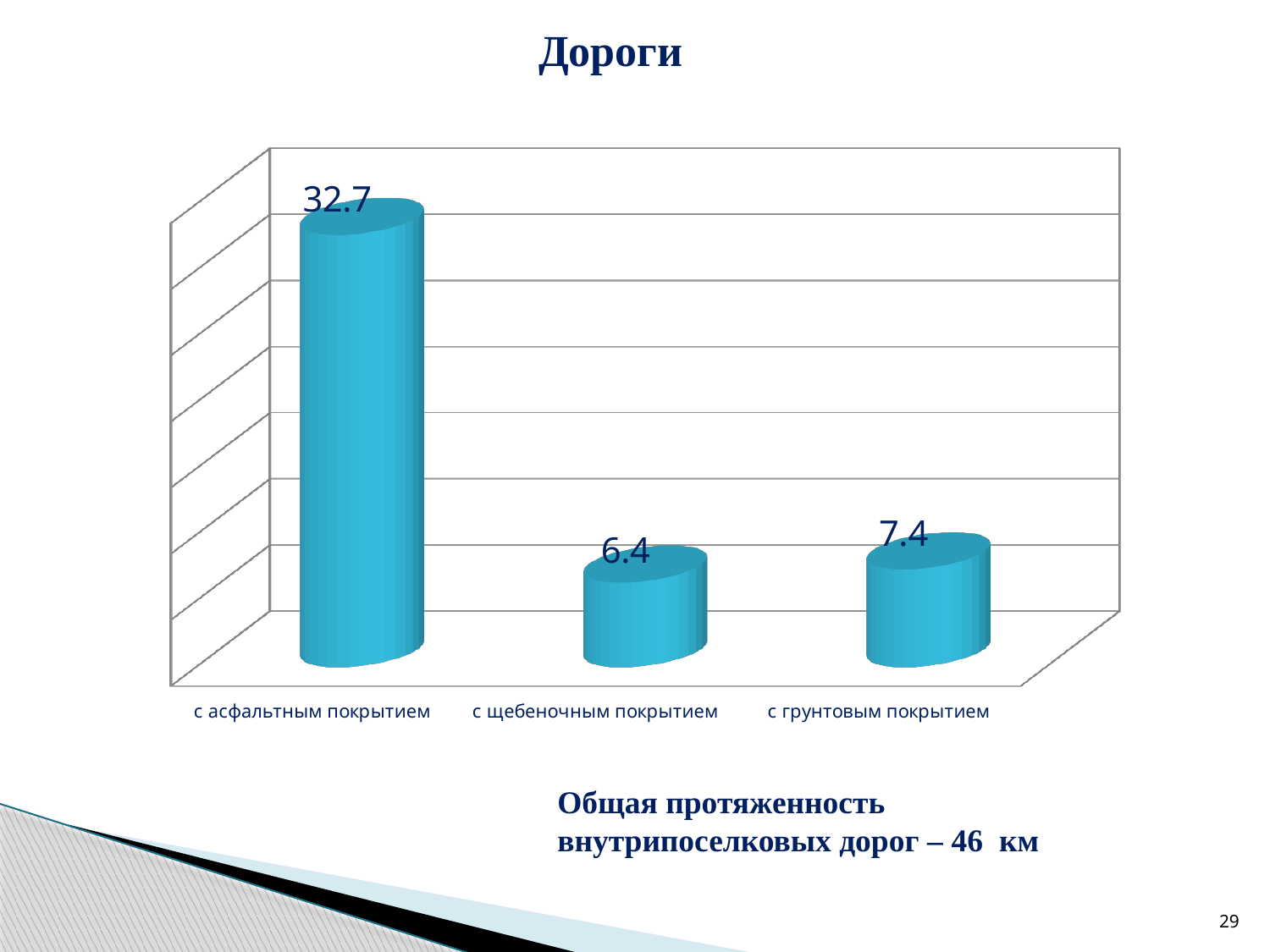
What is the difference between the values for с грунтовым покрытием and с щебеночным покрытием? 1 Which category has the lowest value? с щебеночным покрытием Which category has the highest value? с асфальтным покрытием What kind of chart is shown on the slide? bar chart What is the title of the slide? Дороги What is the value for roads с грунтовым покрытием? 7.4 What total length of intra-settlement roads is stated on the slide? 46 км What is the difference between the values for с асфальтным покрытием and с грунтовым покрытием? 25.3 How many categories are shown in the chart? 3 Which is larger: the value for с грунтовым покрытием or с щебеночным покрытием? с грунтовым покрытием What is the value for roads с асфальтным покрытием? 32.7 What is the value for roads с щебеночным покрытием? 6.4